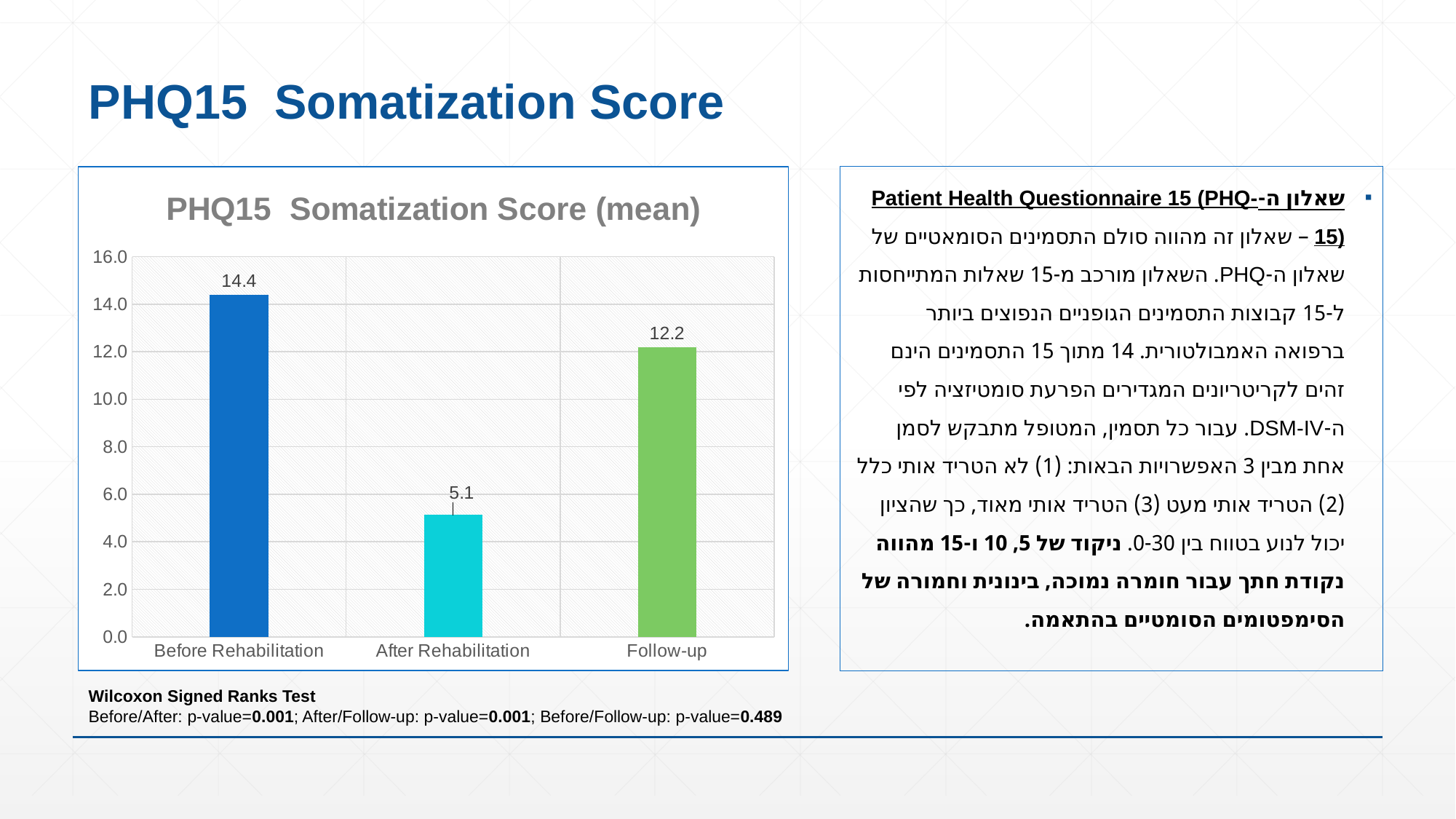
What is the mean PHQ15 Somatization Score after rehabilitation? 5.1 What is the difference between the mean score before rehabilitation and after rehabilitation? 9.3 What is the mean PHQ15 Somatization Score before rehabilitation? 14.4 Which category has the lowest mean PHQ15 Somatization Score? After Rehabilitation What is the mean PHQ15 Somatization Score at follow-up? 12.2 What is the title of the chart? PHQ15 Somatization Score (mean) What kind of chart is shown on the slide? bar chart Is the value for After Rehabilitation greater or less than 6.0? less Which is larger, the mean score before rehabilitation or at follow-up? Before Rehabilitation Which category has the highest mean PHQ15 Somatization Score? Before Rehabilitation How many categories are shown on the x axis of the chart? 3 What is the difference between the mean score at follow-up and after rehabilitation? 7.1